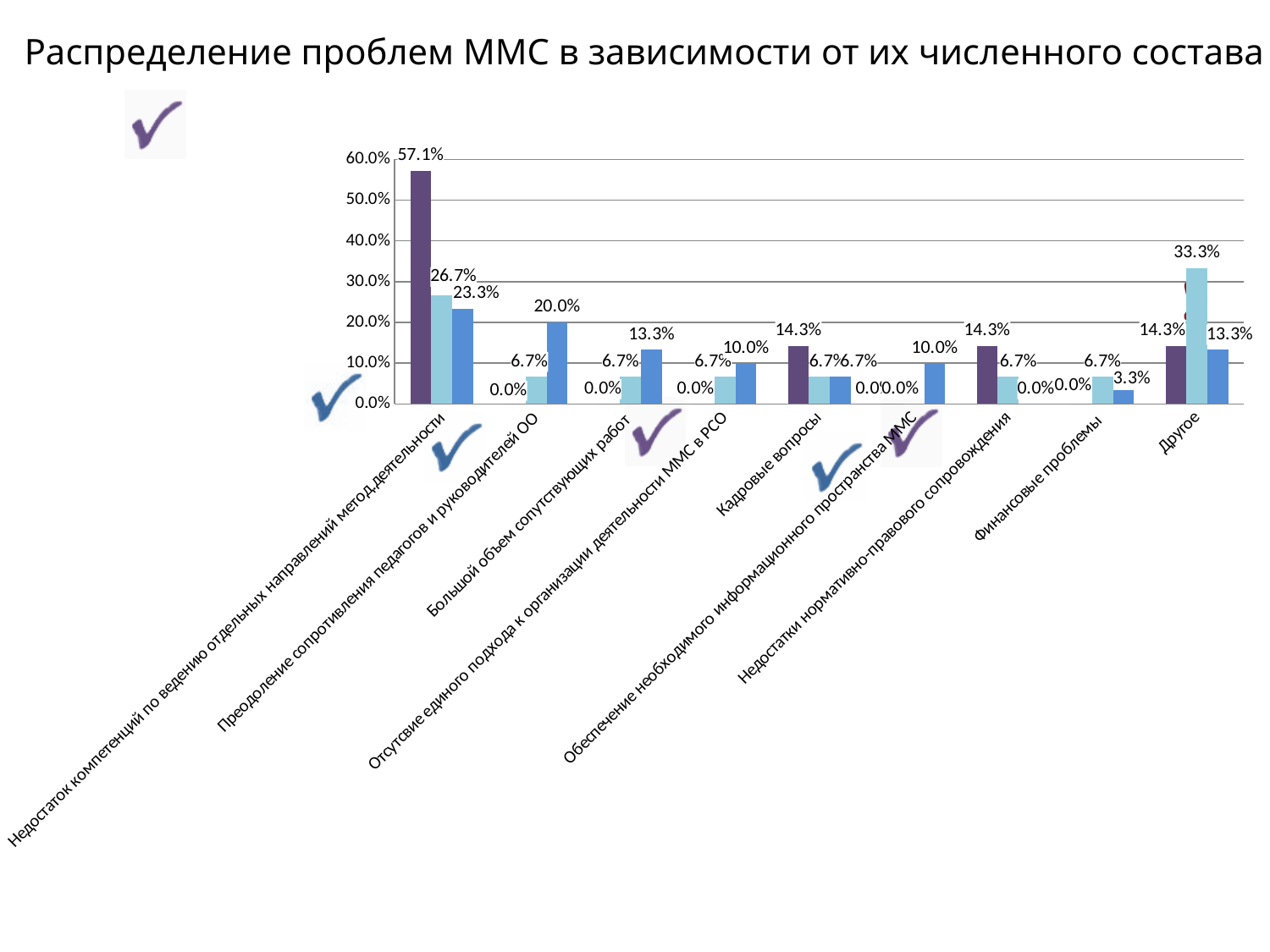
For 'Большой объем сопутствующих работ', which is larger: the light blue bar or the blue (third) bar? the blue (third) bar How many categories are shown on the x axis of the chart? 9 What is the value of the light blue bar for 'Другое'? 33.3% What is the value of the blue (third) bar for 'Финансовые проблемы'? 3.3% Which category has the highest dark purple bar? Недостаток компетенций по ведению отдельных направлений метод.деятельности Is the value of the dark purple bar for 'Недостаток компетенций по ведению отдельных направлений метод.деятельности' greater or less than 50.0%? greater What is the difference between the dark purple bar (57.1%) and the light blue bar (26.7%) for 'Недостаток компетенций по ведению отдельных направлений метод.деятельности'? 30.4% What is the value of the dark purple bar for 'Кадровые вопросы'? 14.3% Which category has the highest light blue bar? Другое What is the value of the blue (third) bar for 'Преодоление сопротивления педагогов и руководителей ОО'? 20.0% What is the title of the slide? Распределение проблем ММС в зависимости от их численного состава What kind of chart is shown on the slide? bar chart